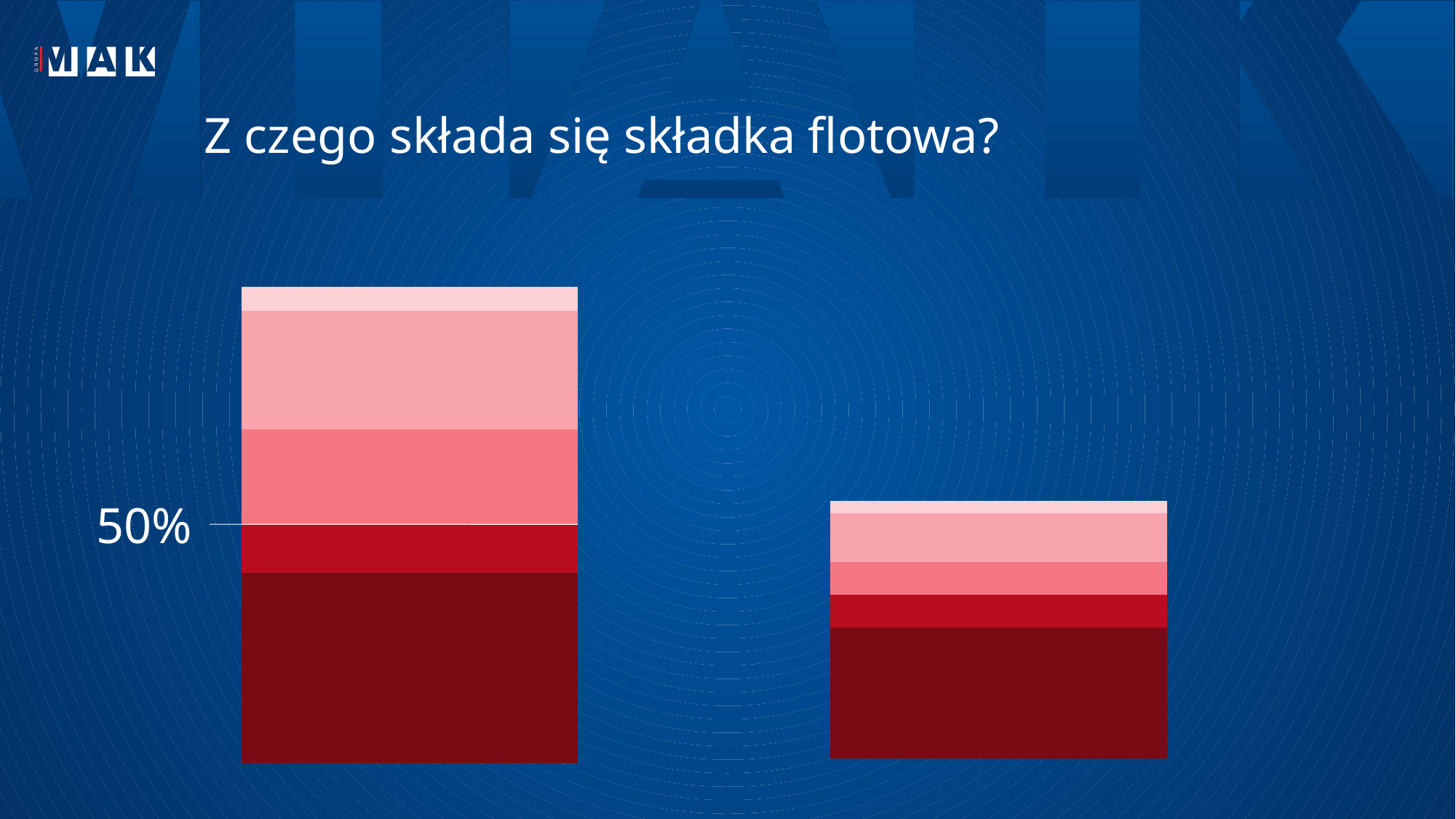
What is the only value label shown on the vertical axis of the chart? 50% How many stacked segments does the left bar contain? 5 How many bars are plotted in the chart? 2 Which bar is taller, the left bar or the right bar? the left bar What is the title of the chart on the slide? Z czego składa się składka flotowa? Which segment is the largest in the left bar, the bottom dark red segment or the top light pink segment? the bottom dark red segment How many stacked segments does the right bar contain? 5 Is the total height of the left bar greater or less than 50%? greater What kind of chart is shown on the slide? stacked bar chart Do the bar heights rise or fall from left to right? fall